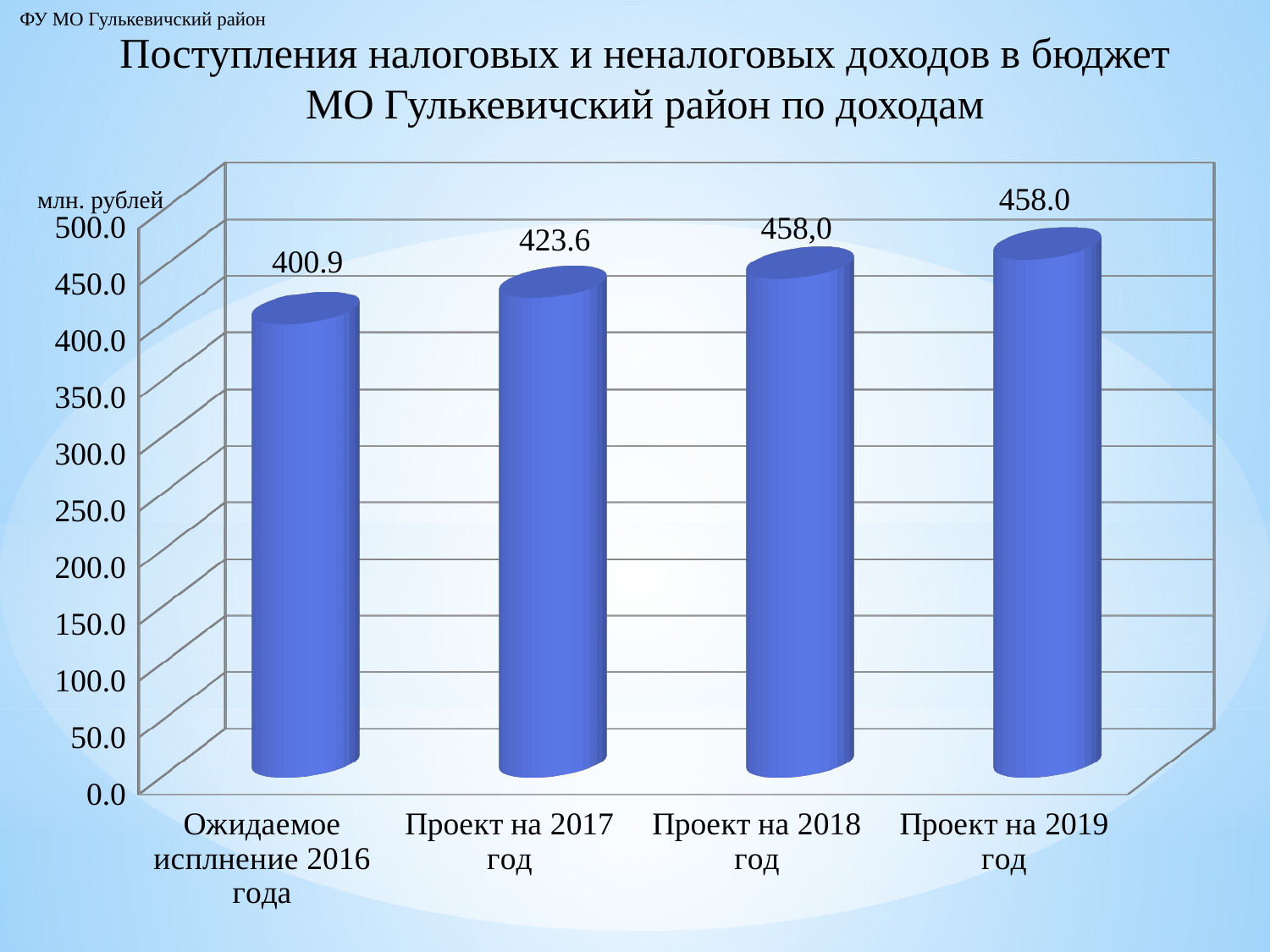
What unit is indicated for the values on the chart? млн. рублей What is the difference between the values for "Проект на 2017 год" and "Ожидаемое исплнение 2016 года"? 22.7 What kind of chart is shown on the slide? bar chart What is the value for "Проект на 2017 год"? 423.6 What is the value for "Ожидаемое исплнение 2016 года"? 400.9 How many categories are shown on the x axis? 4 Which is larger, the value for "Проект на 2017 год" or for "Ожидаемое исплнение 2016 года"? Проект на 2017 год Is the value for "Ожидаемое исплнение 2016 года" greater or less than 450.0? less What is the difference between the values for "Проект на 2019 год" and "Проект на 2017 год"? 34.4 Which category has the lowest value? Ожидаемое исплнение 2016 года What is the value for "Проект на 2019 год"? 458.0 What is the value for "Проект на 2018 год"? 458,0